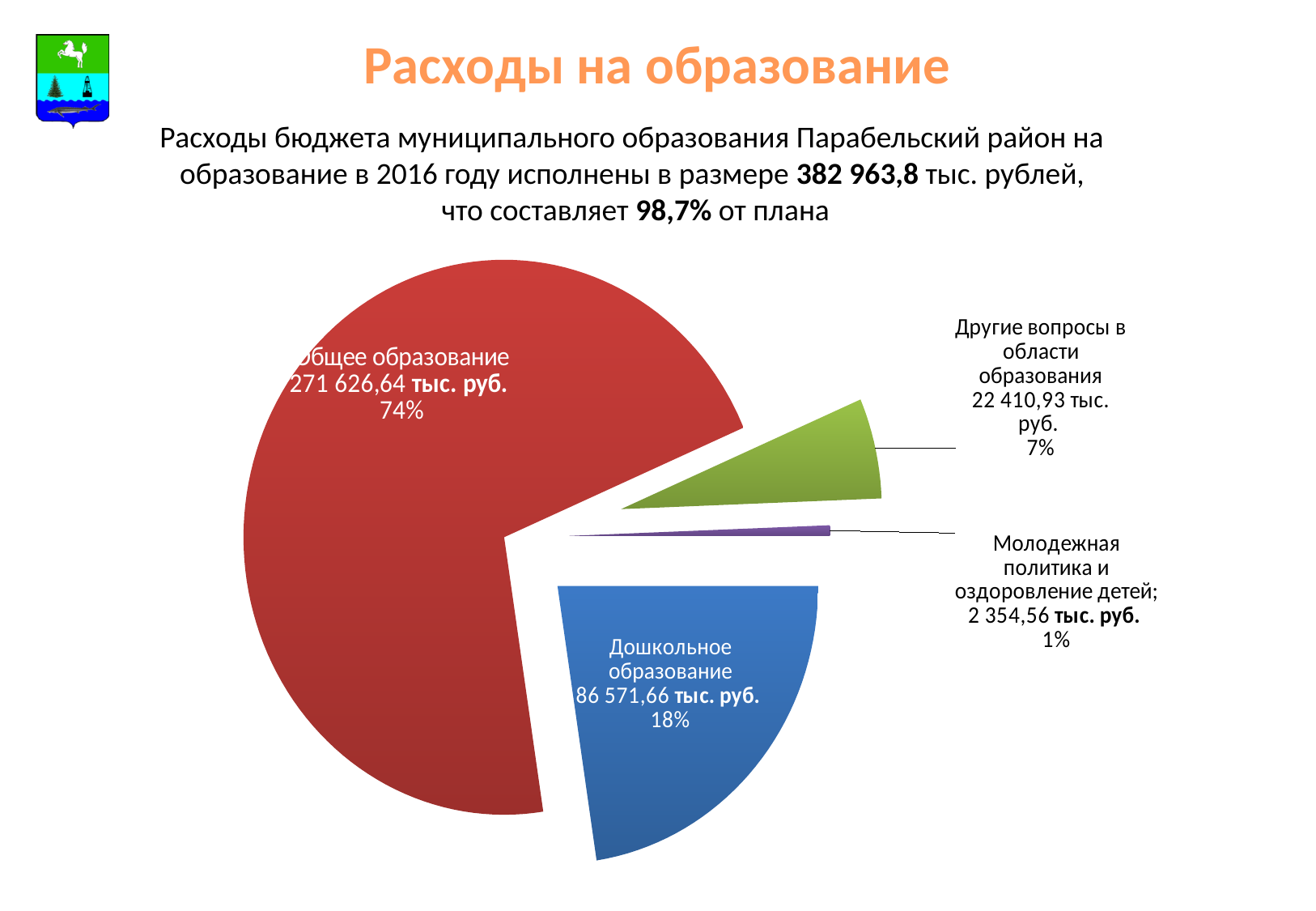
What kind of chart is shown on the slide? Pie chart What is the value for Общее образование? 271 626,64 тыс. руб. What is the difference between the values for Общее образование and Дошкольное образование? 185 054,98 тыс. руб. How many slices does the pie chart have? 4 Which is larger, the value for Дошкольное образование or the value for Другие вопросы в области образования? Дошкольное образование What share of the pie does Другие вопросы в области образования represent? 7% What share of the pie does Дошкольное образование represent? 18% Which category has the largest slice of the pie? Общее образование What is the value for Дошкольное образование? 86 571,66 тыс. руб. What is the value for Молодежная политика и оздоровление детей? 2 354,56 тыс. руб. What is the value for Другие вопросы в области образования? 22 410,93 тыс. руб. Which category has the smallest slice of the pie? Молодежная политика и оздоровление детей